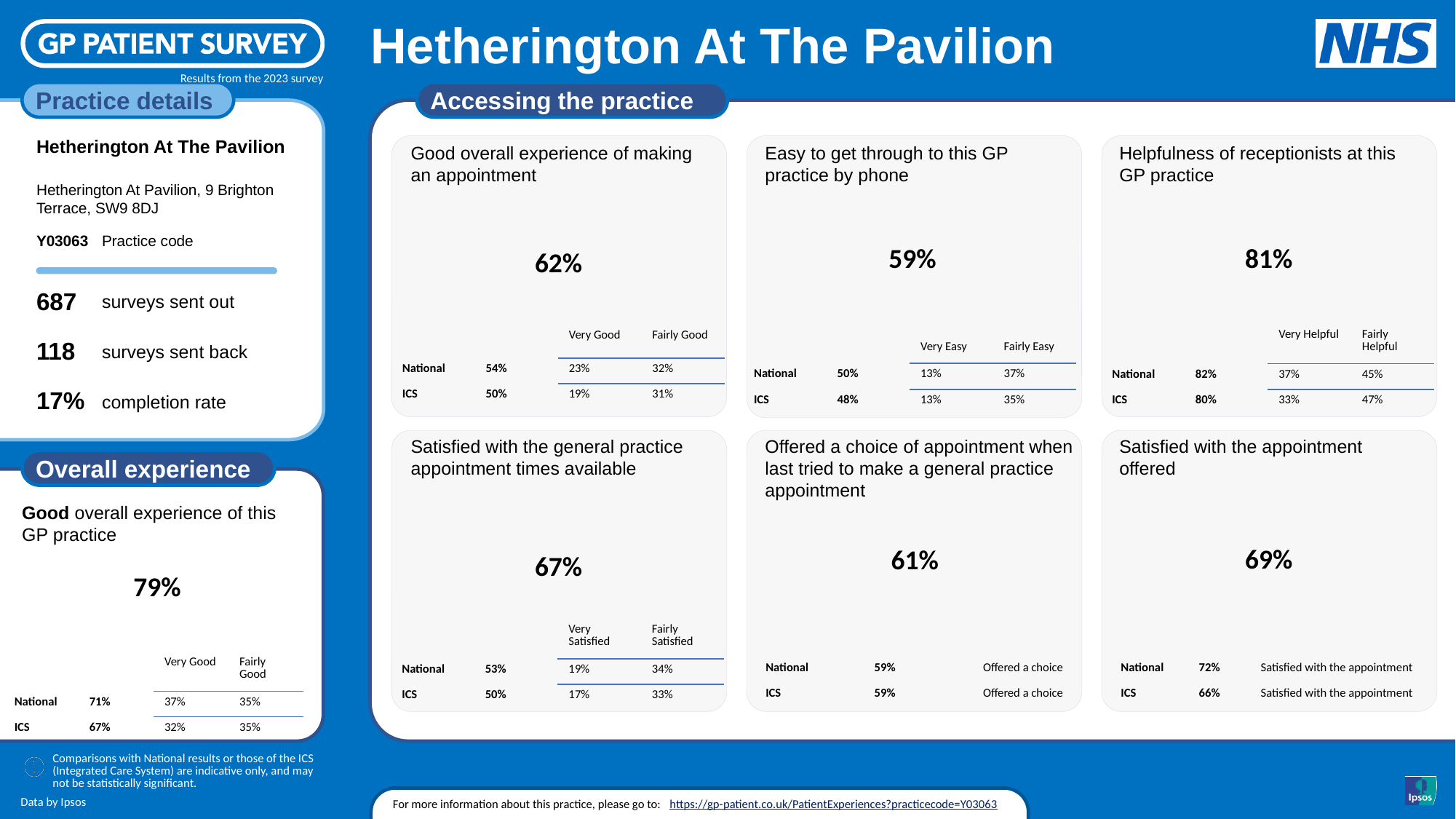
Across the six 'Accessing the practice' panels, which measure has the lowest practice headline percentage? Easy to get through to this GP practice by phone On the 'Helpfulness of receptionists at this GP practice' panel, what is the ICS percentage for Fairly Helpful? 47% On the 'Easy to get through to this GP practice by phone' panel, what is the National value? 50% How many panels are shown in the 'Accessing the practice' section? 6 Across the six 'Accessing the practice' panels, which measure has the highest practice headline percentage? Helpfulness of receptionists at this GP practice On the 'Offered a choice of appointment' panel, what is the ICS value? 59% On the 'Satisfied with the appointment offered' panel, what is the difference between the practice headline value and the National value? 3% On the 'Good overall experience of making an appointment' panel, what is the headline percentage for the practice? 62% On the 'Good overall experience of making an appointment' panel, what is the total of the ICS Very Good and Fairly Good percentages? 50% On the 'Satisfied with the general practice appointment times available' panel, what is the National percentage for Very Satisfied? 19% On the 'Good overall experience of this GP practice' panel, what are the two response categories listed in the table header? Very Good and Fairly Good On the 'Good overall experience of this GP practice' panel, which is larger, the National value or the ICS value? National